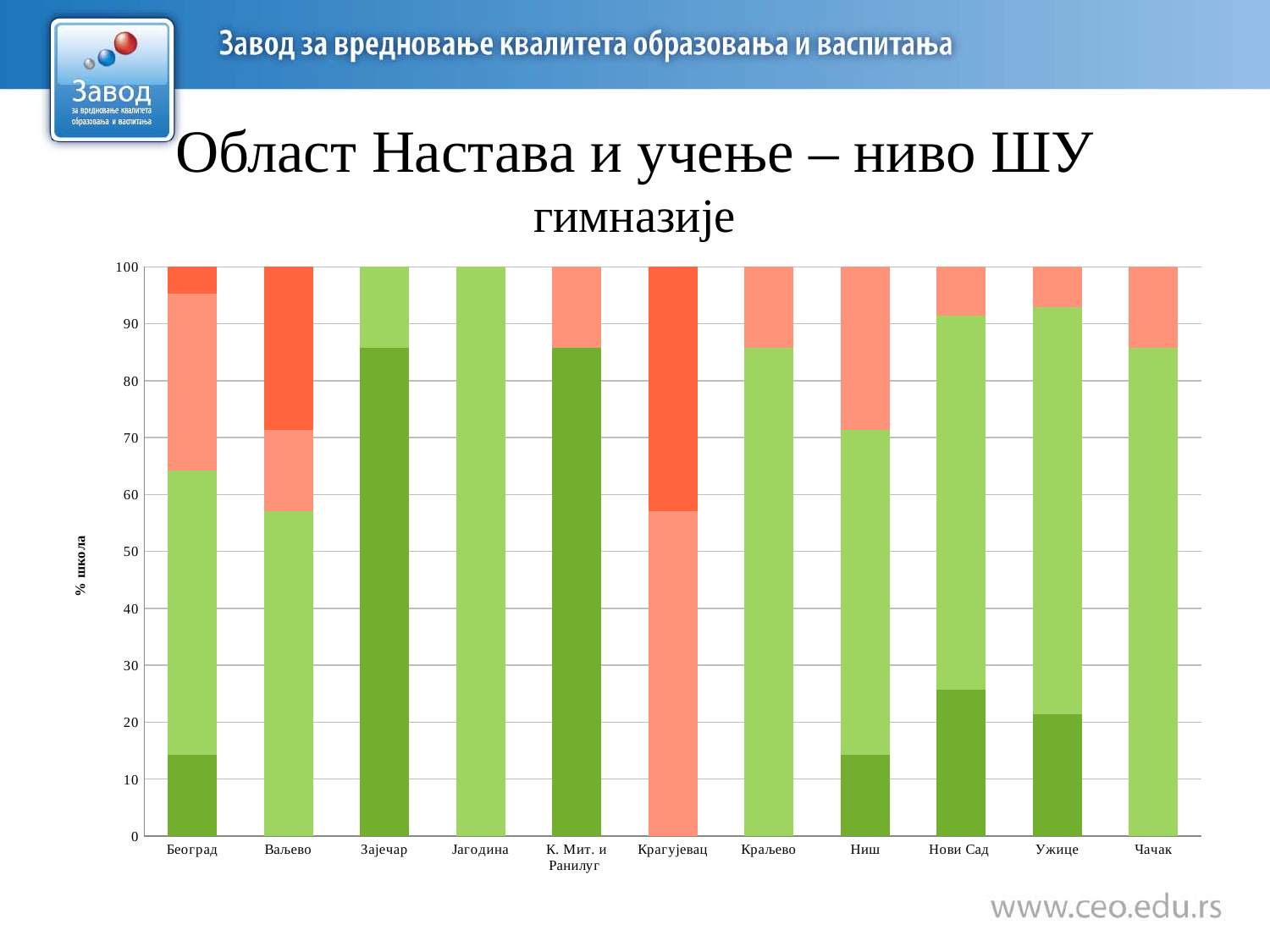
Is the dark green segment for Зајечар greater or less than 80? greater Which category has a larger dark green segment, Нови Сад or Ужице? Нови Сад Is the dark green segment for Београд greater or less than 20? less What is the title of the slide containing the chart? Област Настава и учење – ниво ШУ гимназије Is the light orange (salmon) segment for Крагујевац greater or less than 50? greater Which category's bar consists entirely of the light green segment? Јагодина Which category has the largest dark orange segment, Ваљево or Крагујевац? Крагујевац How many categories (school administrations) are shown on the x axis? 11 What is the label of the y axis? % школа What kind of chart is shown on the slide? stacked bar chart What is the maximum value shown on the y axis? 100